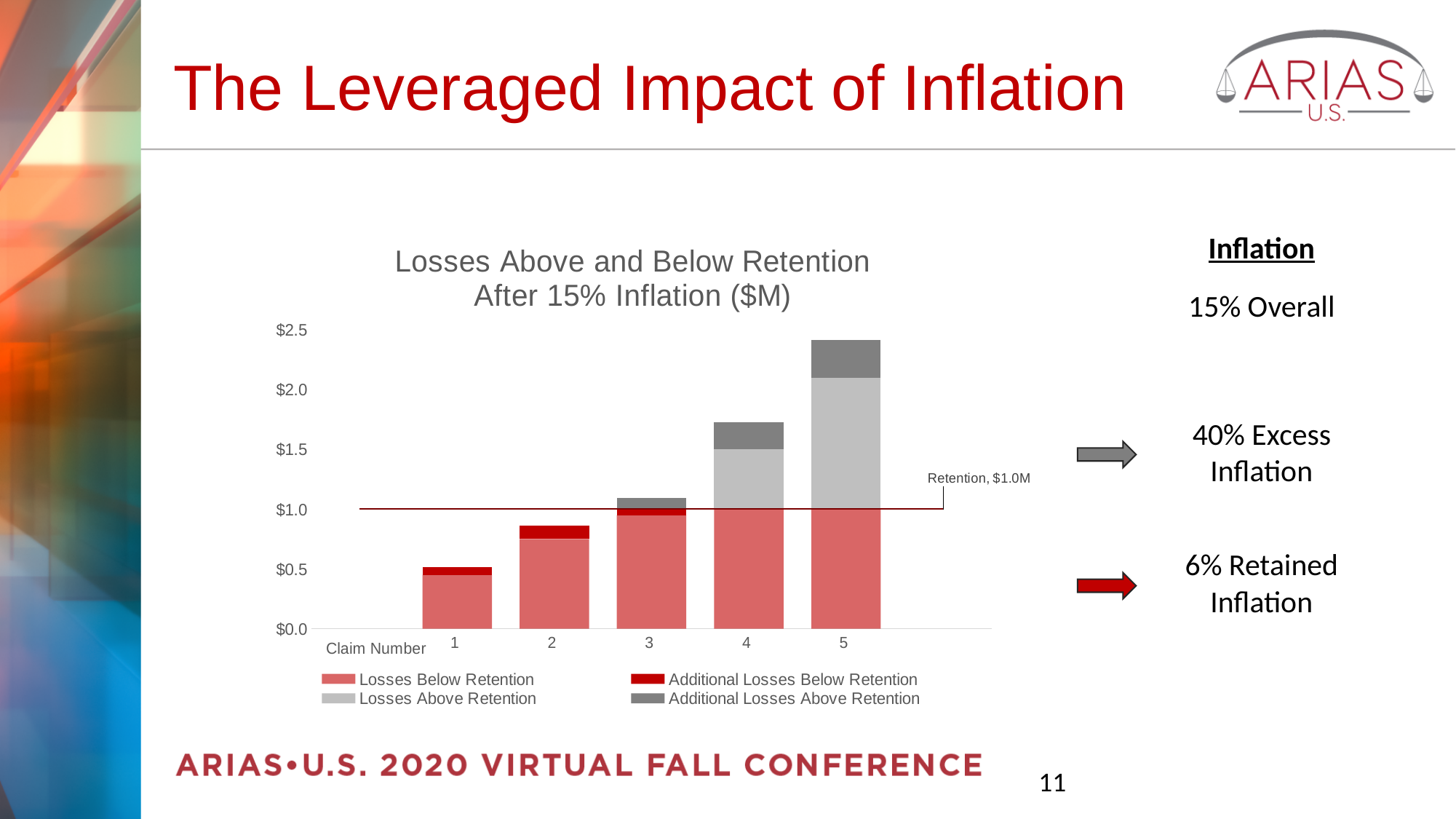
Which claim number has the tallest stacked bar? 5 Do the stacked bar totals rise or fall as the claim number increases from 1 to 5? rise What is the title of the chart? Losses Above and Below Retention After 15% Inflation ($M) Which claim number has the shortest stacked bar? 1 What value is labelled on the horizontal retention line in the chart? Retention, $1.0M What kind of chart is shown on the slide? Stacked bar chart Is the total bar height for claim 1 greater or less than $1.0? less Is the total bar height for claim 5 greater or less than $2.0? greater How many series does the chart's legend list? 4 Is the total bar height for claim 2 greater or less than $1.0? less How many claim numbers are plotted on the x axis of the chart? 5